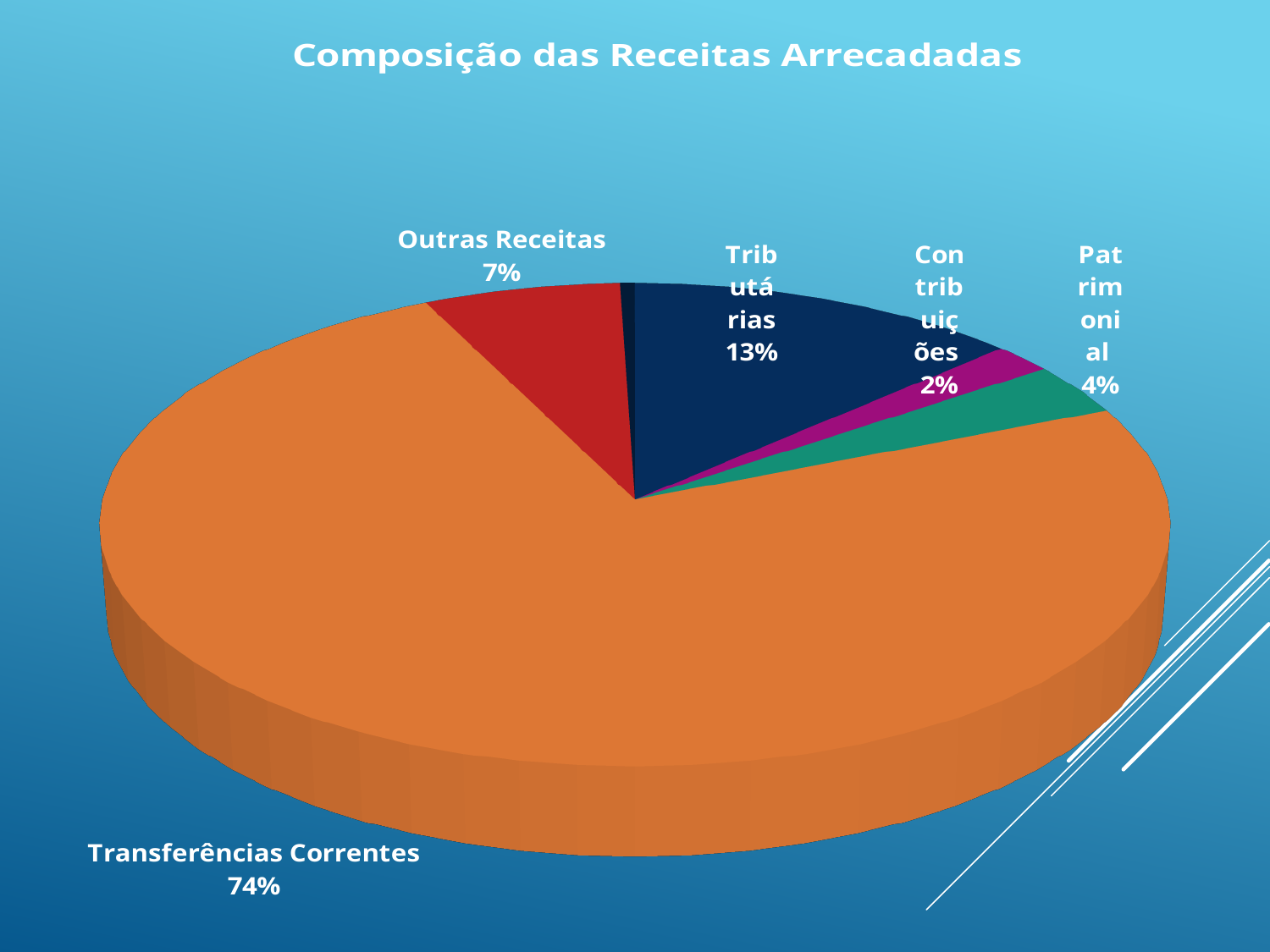
What kind of chart is shown on the slide? Pie chart What is the title of the chart? Composição das Receitas Arrecadadas What percentage is shown for Patrimonial? 4% What percentage is shown for Contribuições? 2% What percentage is shown for Outras Receitas? 7% What share of the pie does Transferências Correntes represent? 74% Which is larger, the share for Patrimonial or the share for Contribuições? Patrimonial What percentage is shown for Tributárias? 13% What is the difference in percentage points between Tributárias and Outras Receitas? 6 Which category has the largest share of the pie? Transferências Correntes